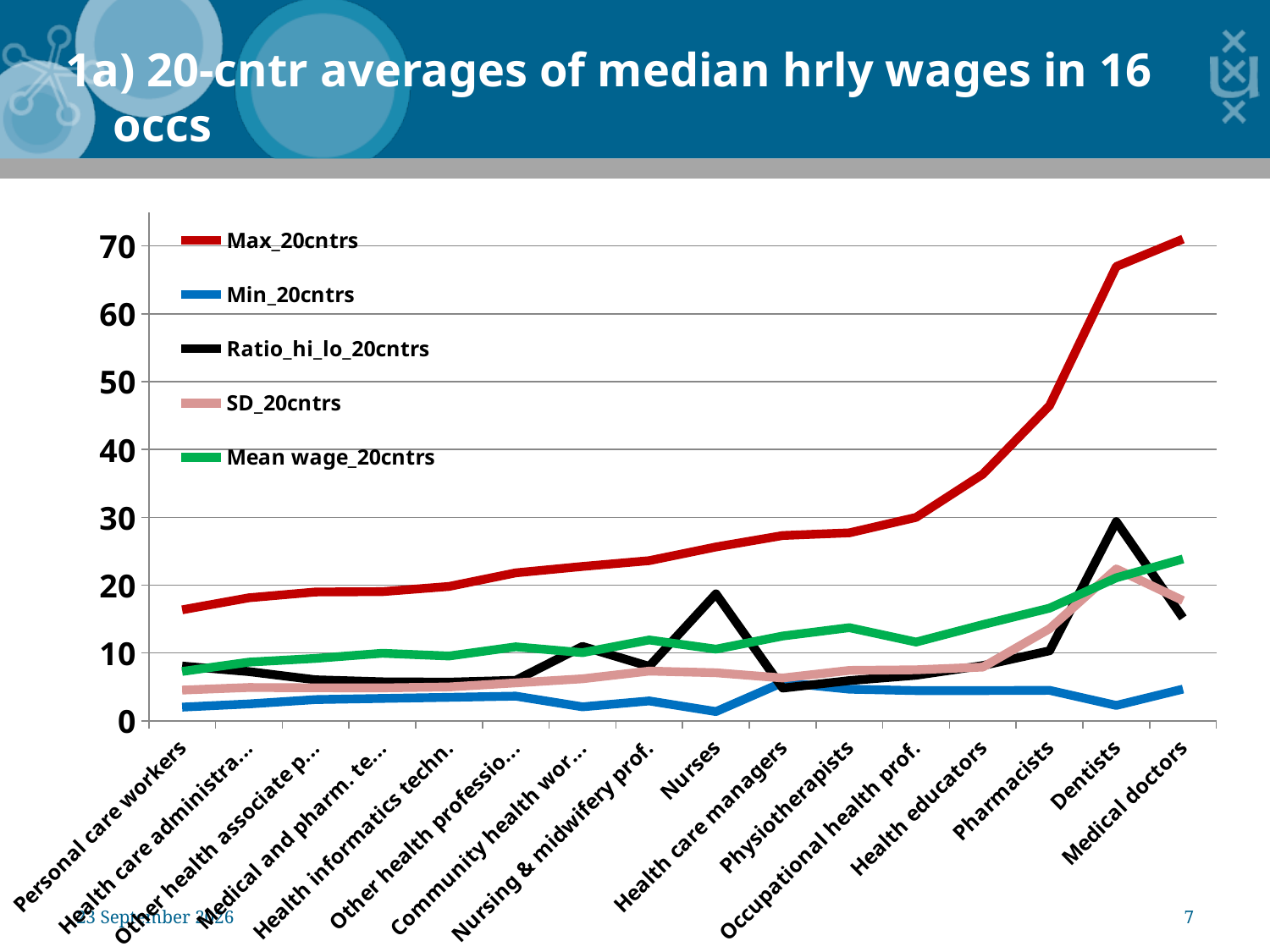
How many series does the legend list? 5 Is the Max_20cntrs value for Dentists greater or less than 60? greater For which occupation does the Ratio_hi_lo_20cntrs series reach its highest value? Dentists Is the Ratio_hi_lo_20cntrs value for Dentists greater or less than 20? greater Is the Max_20cntrs value for Personal care workers greater or less than 20? less How many occupation categories are plotted along the x axis? 16 For which occupation is the Mean wage_20cntrs series highest? Medical doctors What colour is the Max_20cntrs line in the legend? red What kind of chart is shown on the slide? line chart Which is larger for Ratio_hi_lo_20cntrs: the value for Nurses or the value for Health care managers? Nurses For which occupation is the Max_20cntrs series highest? Medical doctors Does the Max_20cntrs series generally rise or fall from left to right along the x axis? rise